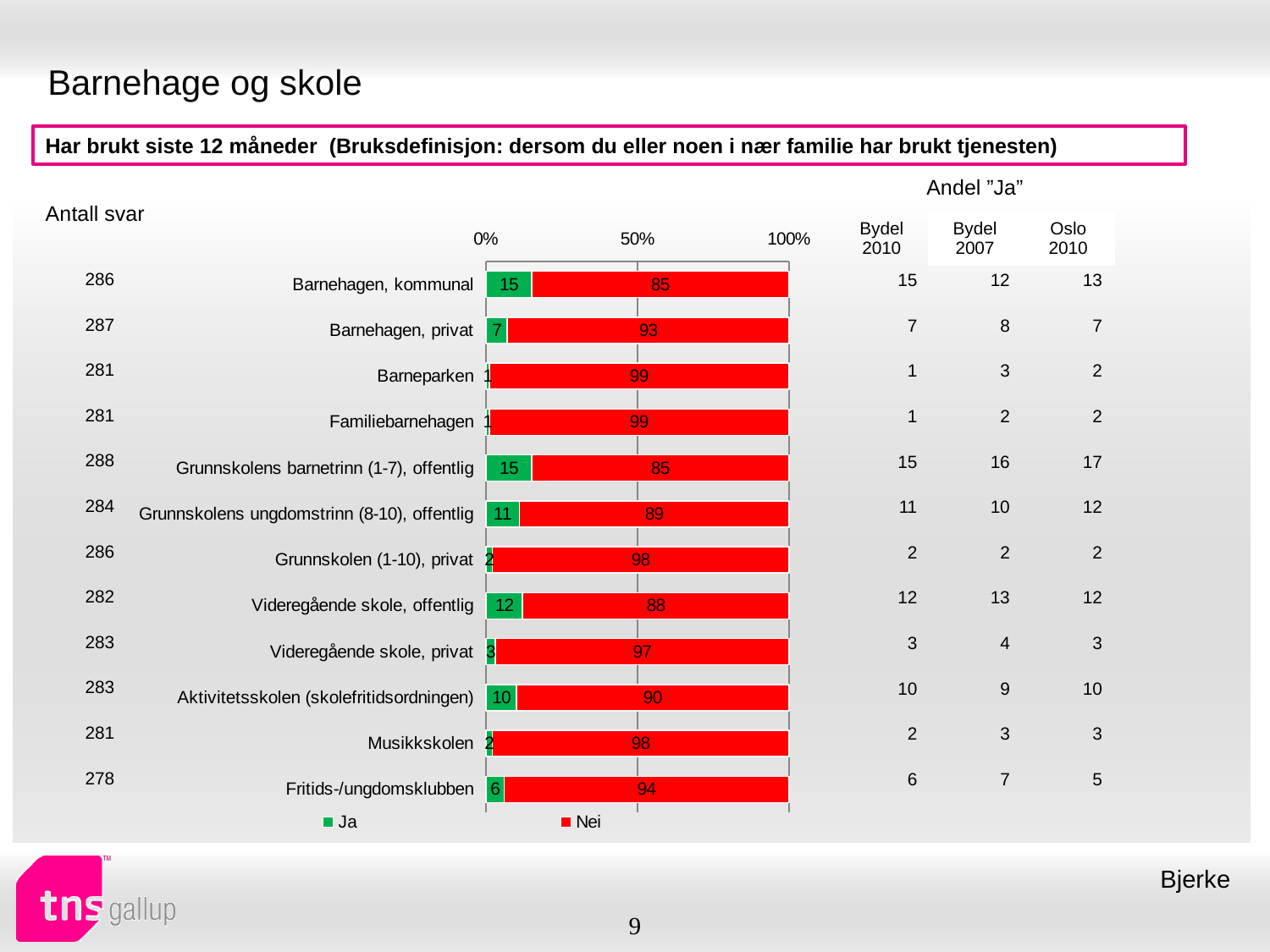
Is the "Nei" value for Musikkskolen greater or less than 50%? greater Which series is shown in red in the chart? Nei Which has a larger "Ja" value: Grunnskolens ungdomstrinn (8-10), offentlig or Videregående skole, privat? Grunnskolens ungdomstrinn (8-10), offentlig What is the total of the stacked bar for Grunnskolens barnetrinn (1-7), offentlig? 100 What is the "Ja" value for Barnehagen, kommunal? 15 What is the "Ja" value for Videregående skole, offentlig? 12 What is the "Nei" value for Aktivitetsskolen (skolefritidsordningen)? 90 How many categories are plotted in the chart? 12 How many series does the chart legend list? 2 What is the difference between the "Nei" values for Barneparken and Fritids-/ungdomsklubben? 5 What is the "Nei" value for Barnehagen, privat? 93 What kind of chart is shown on the slide? stacked bar chart